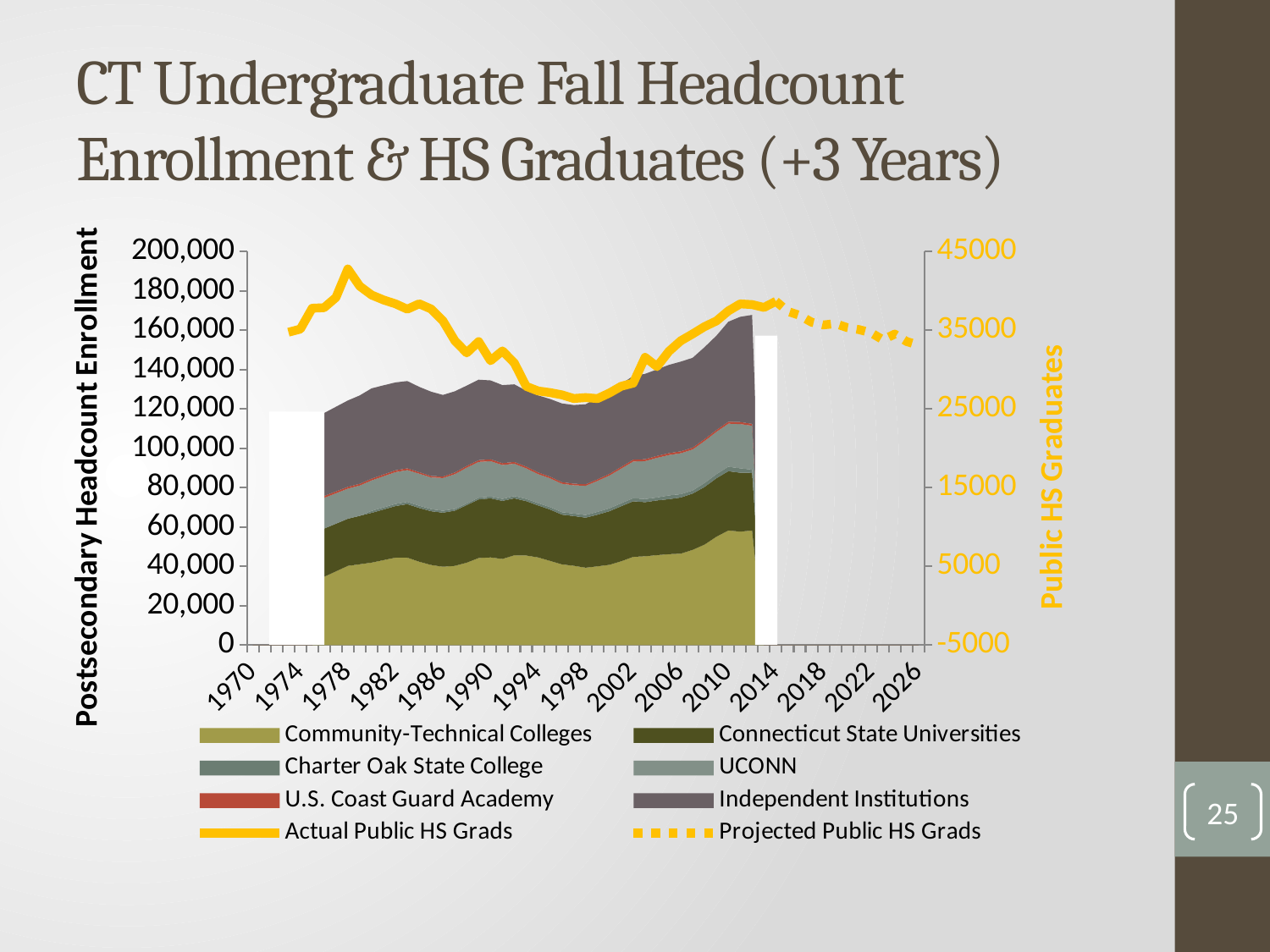
Is the value of Actual Public HS Grads around 1998 greater or less than 35000? less Is the total postsecondary headcount enrollment around 2010 greater or less than 140,000? greater Does the Projected Public HS Grads line rise or fall between 2014 and 2026? fall Does the Actual Public HS Grads line rise or fall between 1978 and 1998? fall What is the title of the right vertical axis? Public HS Graduates How many series does the legend list? 8 Is the total postsecondary headcount enrollment around 1998 greater or less than 140,000? less What kind of chart is shown on the slide? A stacked area chart with line series overlaid What is the title of the left vertical axis? Postsecondary Headcount Enrollment How many year labels are shown on the x axis? 15 Around 2010, which is larger: the Community-Technical Colleges enrollment or the Connecticut State Universities enrollment? Community-Technical Colleges